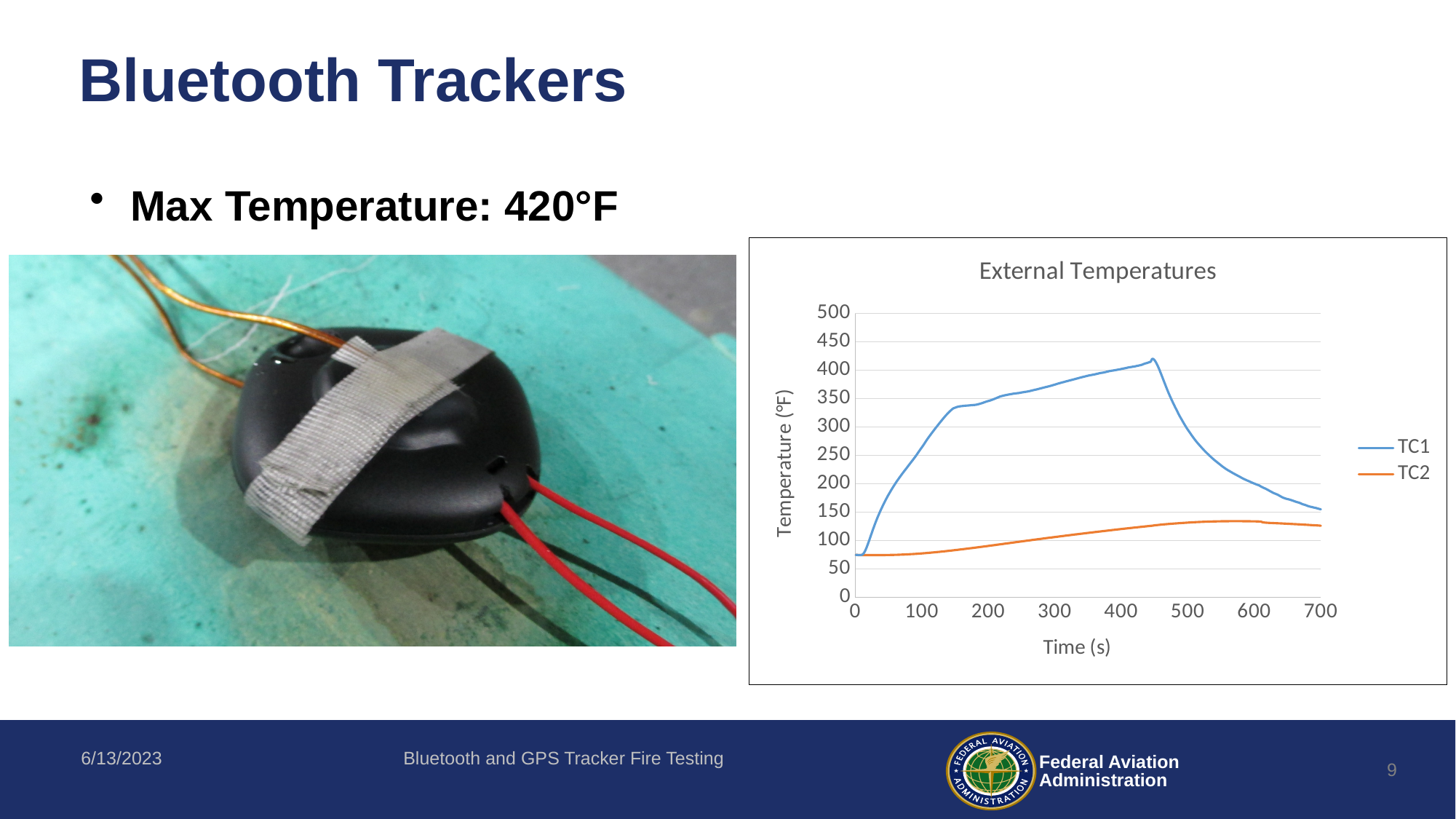
At 400 s, which series has the higher temperature, TC1 or TC2? TC1 Is the value of TC1 at 700 s greater or less than 200? less Is the peak value of TC2 greater or less than 150? less What are the names of the two series in the chart legend? TC1 and TC2 Does the TC1 line rise or fall between 0 s and 400 s? rise What kind of chart is shown on the slide? line chart How many series does the legend of the External Temperatures chart list? 2 Does the TC1 line rise or fall between 500 s and 700 s? fall Which series reaches the higher peak temperature, TC1 or TC2? TC1 Is the value of TC1 at 300 s greater or less than 350? greater What is the title of the chart on the slide? External Temperatures